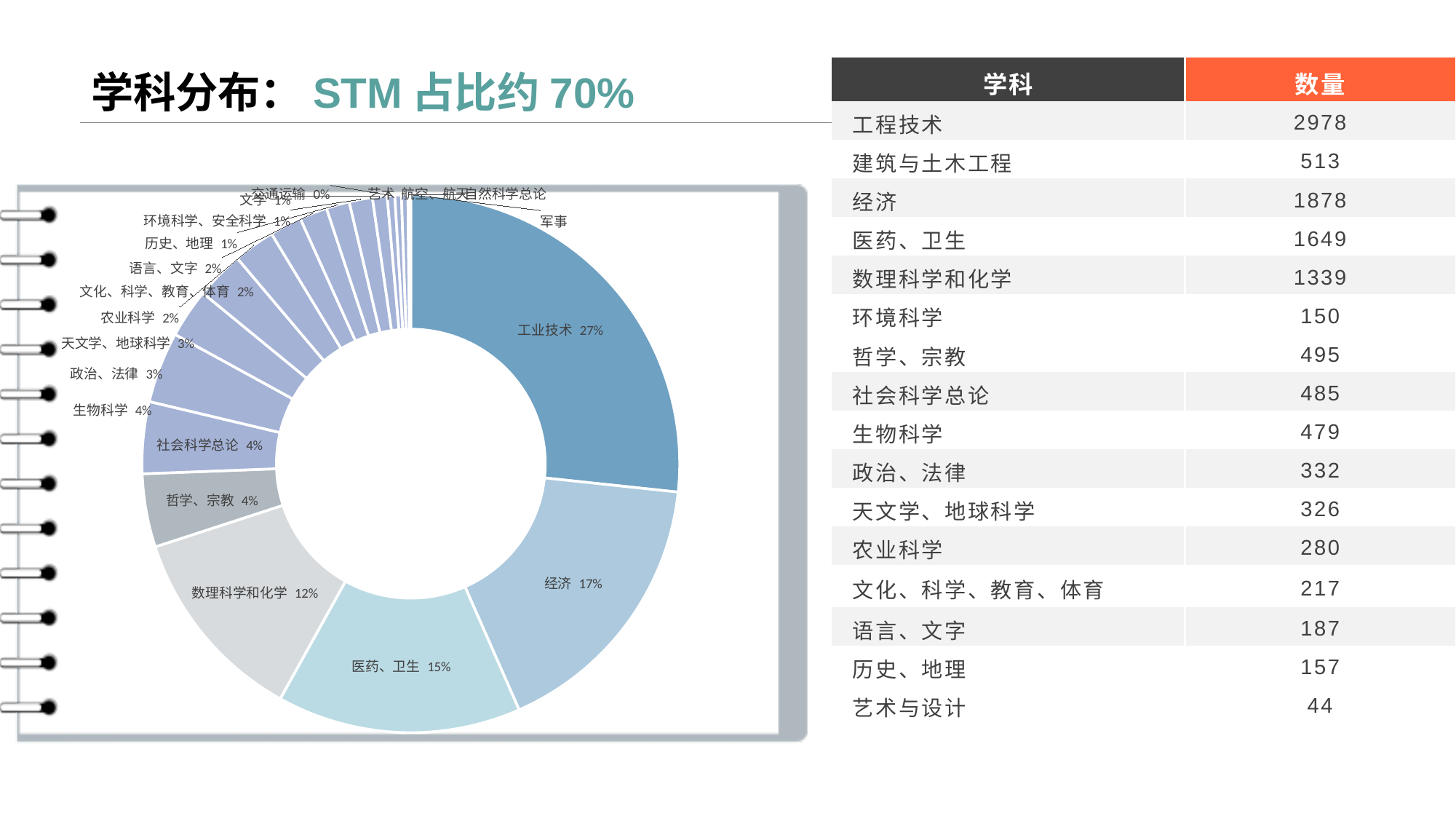
What percentage is shown for 政治、法律 in the doughnut chart? 3% What percentage is shown for 哲学、宗教 in the doughnut chart? 4% What percentage is shown for 数理科学和化学 in the doughnut chart? 12% Which category has the largest slice in the doughnut chart? 工业技术 What percentage is shown for 经济 in the doughnut chart? 17% What share of the doughnut chart does 工业技术 account for? 27% In the doughnut chart, what is the difference in percentage points between 工业技术 and 经济? 10 In the doughnut chart, which slice is larger: 医药、卫生 or 数理科学和化学? 医药、卫生 What kind of chart is shown on the left of the slide? Doughnut (pie) chart What percentage is shown for 交通运输 in the doughnut chart? 0% What percentage is shown for 医药、卫生 in the doughnut chart? 15% What is the title of the slide containing the doughnut chart? 学科分布： STM 占比约 70%